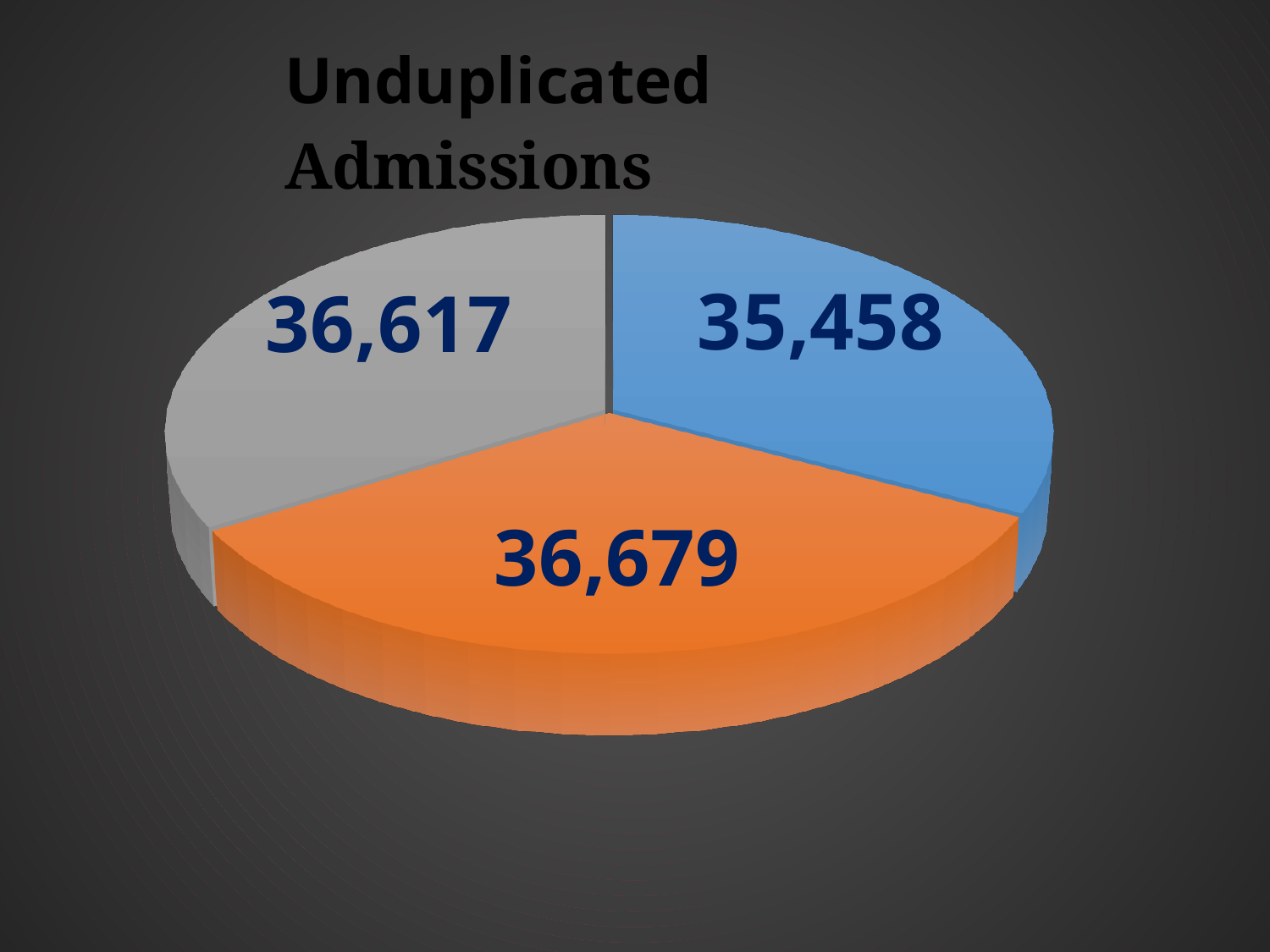
What value is shown on the gray slice of the pie chart? 36,617 How many slices does the pie chart have? 3 What value is shown on the blue slice of the pie chart? 35,458 What is the title of the chart? Unduplicated Admissions What is the difference between the orange slice value and the blue slice value? 1,221 What value is shown on the orange slice of the pie chart? 36,679 What kind of chart is shown on the slide? Pie chart Which slice of the pie chart has the largest value? The orange slice (36,679) What is the total of all three slice values in the pie chart? 108,754 Which is larger, the value on the gray slice or the value on the blue slice? The gray slice (36,617) What is the difference between the orange slice value and the gray slice value? 62 Which slice of the pie chart has the smallest value? The blue slice (35,458)